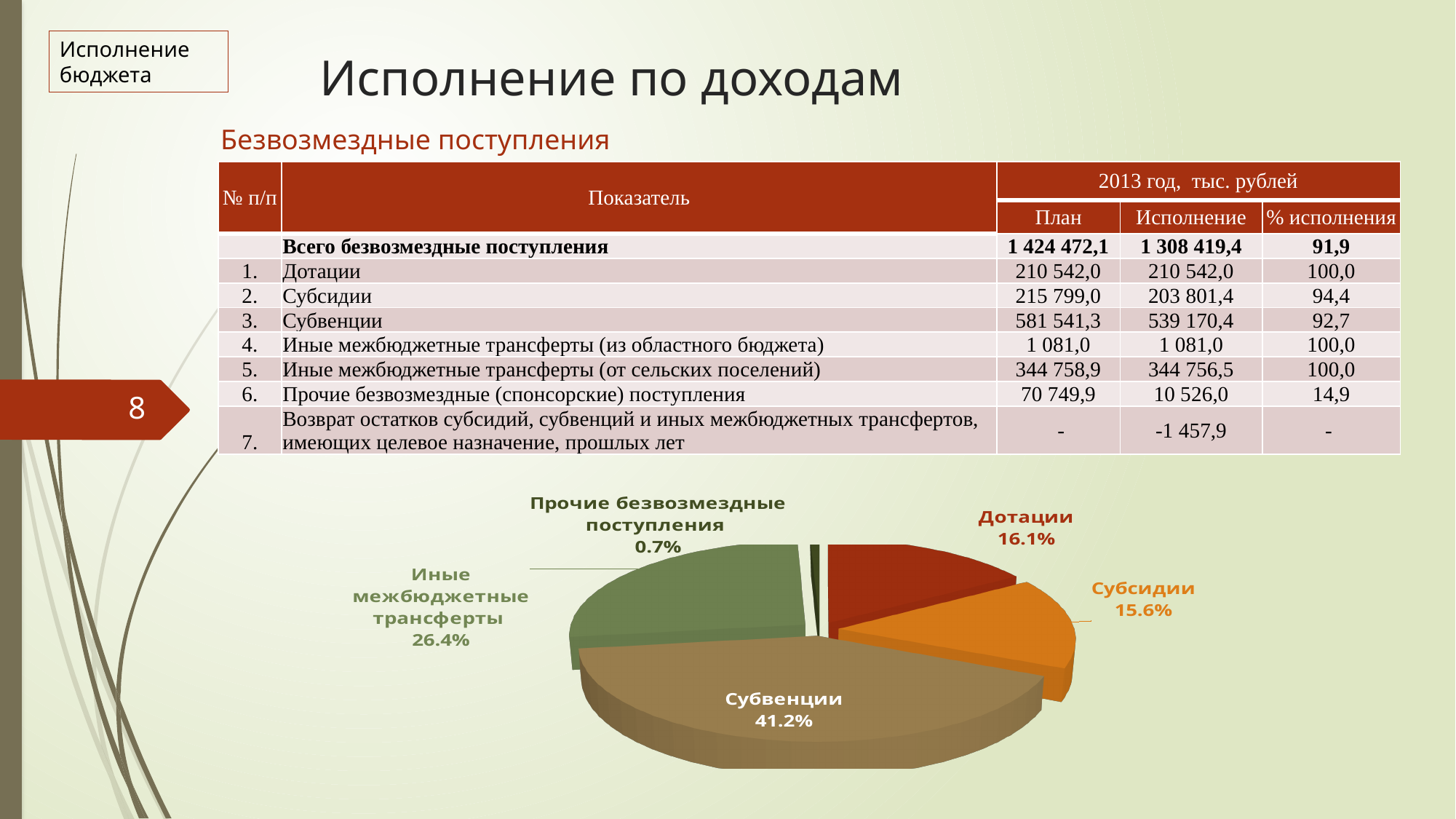
In the pie chart, what is the difference in percentage points between Субвенции and Иные межбюджетные трансферты? 14.8 What share of the pie chart is labelled for Дотации? 16.1% What kind of chart is shown on the slide? Pie chart What share of the pie chart is labelled for Иные межбюджетные трансферты? 26.4% In the pie chart, which is larger: Иные межбюджетные трансферты or Дотации? Иные межбюджетные трансферты Which slice of the pie chart is the largest? Субвенции In the pie chart, what colour is the Субсидии slice? Orange How many slices does the pie chart have? 5 What share of the pie chart is labelled for Субсидии? 15.6% Which slice of the pie chart is the smallest? Прочие безвозмездные поступления